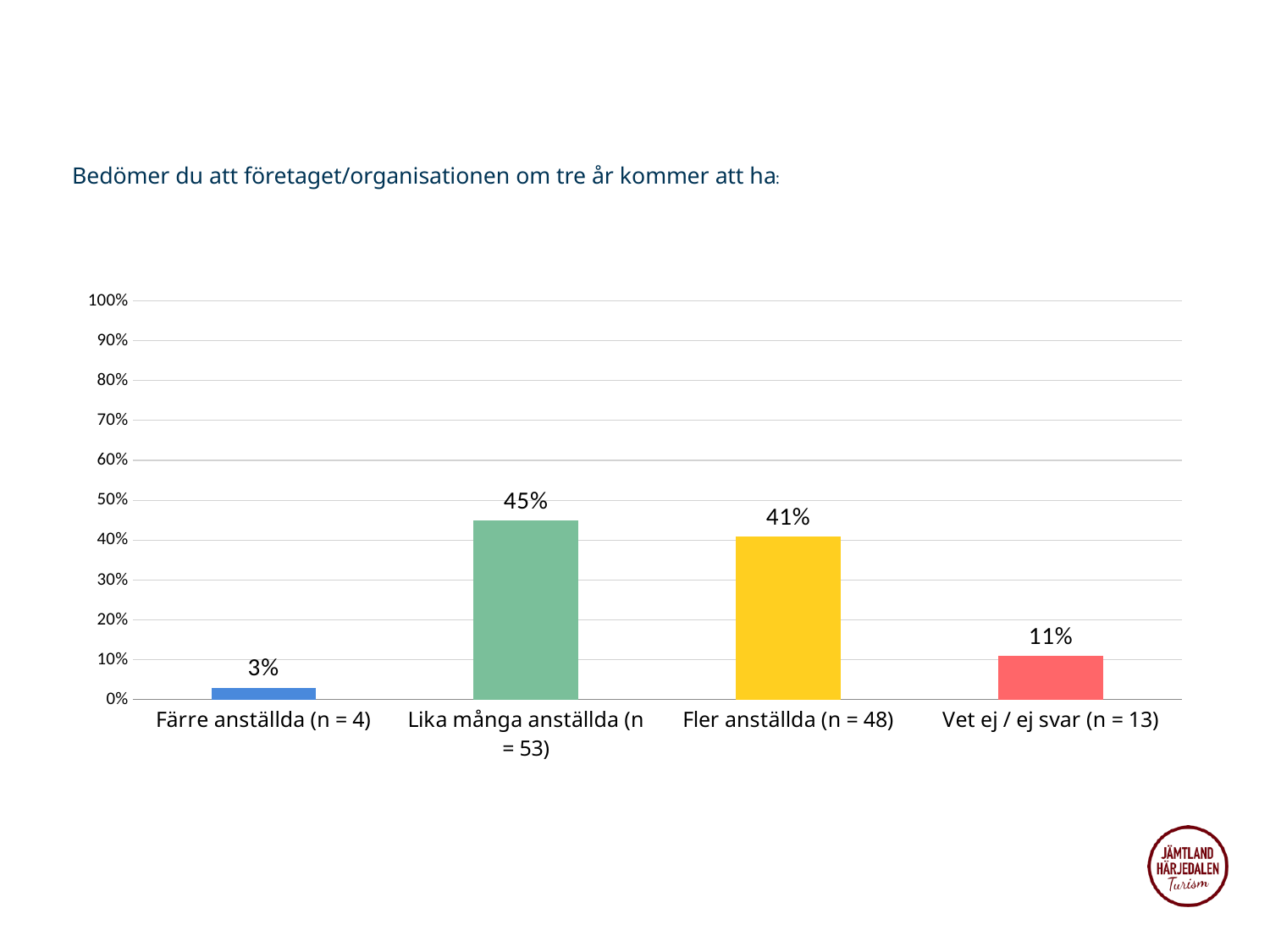
What is the value for "Färre anställda (n = 4)"? 3% What is the value for "Lika många anställda (n = 53)"? 45% What is the value for "Vet ej / ej svar (n = 13)"? 11% What is the difference between the values for "Lika många anställda (n = 53)" and "Fler anställda (n = 48)"? 4% Which is larger, the value for "Fler anställda (n = 48)" or the value for "Vet ej / ej svar (n = 13)"? Fler anställda (n = 48) Which category has the lowest value? Färre anställda (n = 4) How many categories are shown on the x axis? 4 What colour is the bar for "Fler anställda (n = 48)"? yellow Which category has the highest value? Lika många anställda (n = 53) What kind of chart is shown on the slide? bar chart What is the difference between the values for "Vet ej / ej svar (n = 13)" and "Färre anställda (n = 4)"? 8% Is the value for "Fler anställda (n = 48)" greater or less than 50%? less